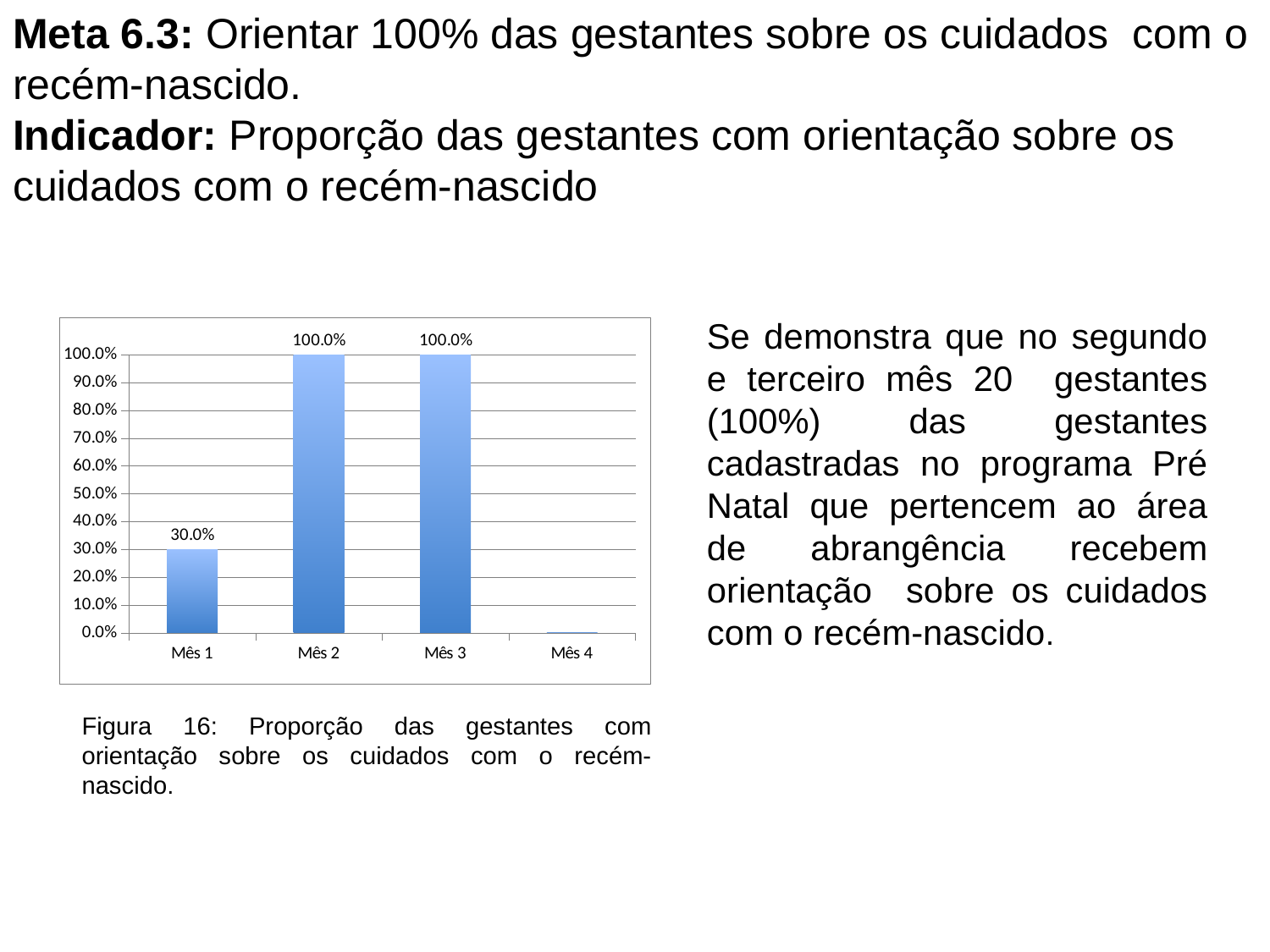
What is the value for Mês 1? 30.0% Is the value for Mês 2 greater or less than 90.0%? greater What is the value for Mês 2? 100.0% What is the difference between the values for Mês 2 and Mês 1? 70.0% What figure number is given in the caption below the chart? Figura 16 What is the value for Mês 3? 100.0% Is the value for Mês 1 greater or less than 50.0%? less Does the value rise or fall from Mês 1 to Mês 2? rise What kind of chart is shown on the slide? bar chart Which is larger, the value for Mês 1 or the value for Mês 3? Mês 3 How many categories are shown on the x axis of the chart? 4 What is the highest tick value shown on the y axis of the chart? 100.0%